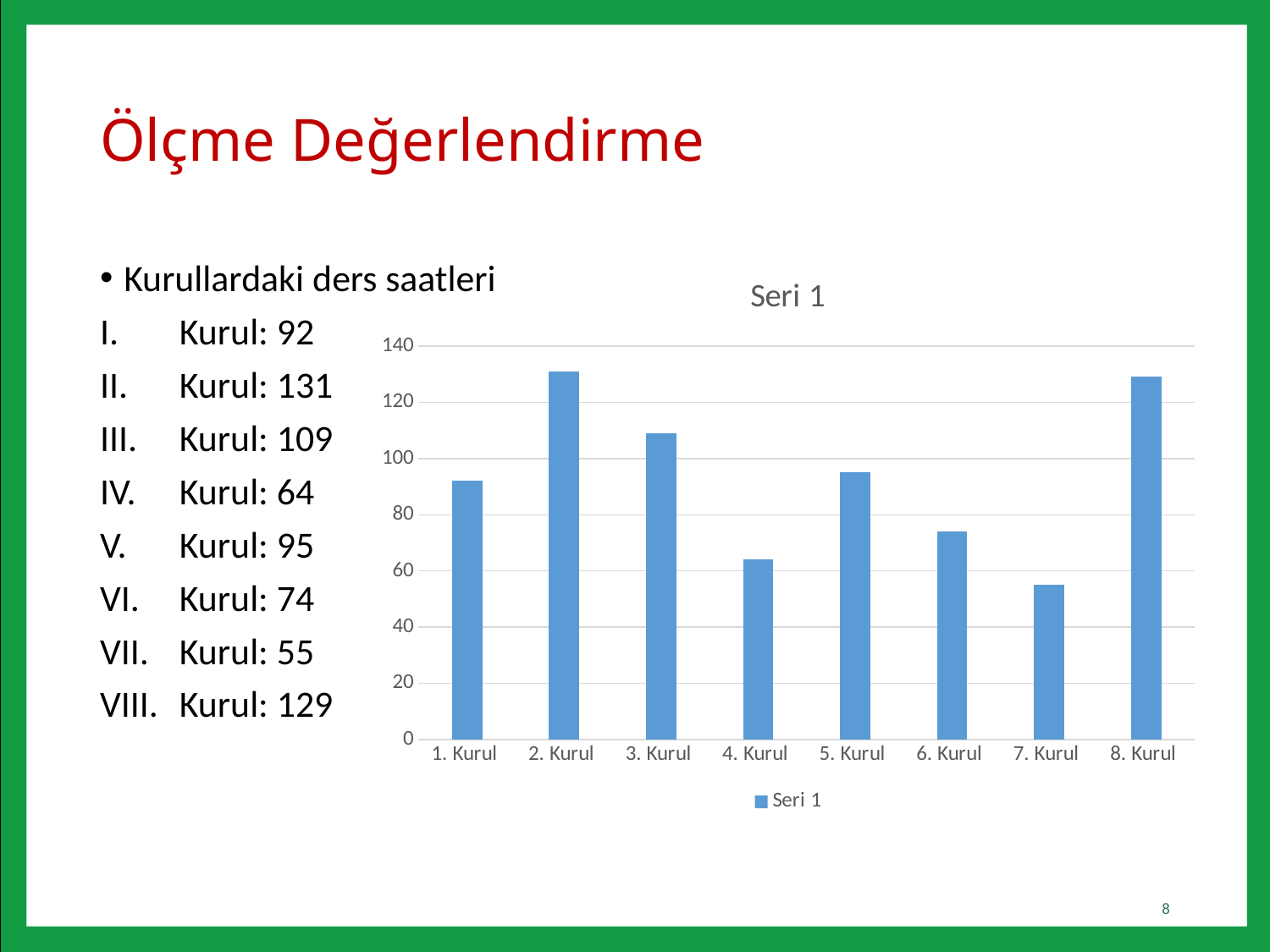
According to the slide, what is the number of ders saatleri for II. Kurul? 131 According to the values listed on the slide, what is the difference between II. Kurul (131) and VII. Kurul (55)? 76 How many categories (Kurul) are shown on the x axis of the chart? 8 Is the value for 8. Kurul greater or less than 120? greater How many series does the chart legend list? 1 Which is larger, the bar for 3. Kurul or the bar for 6. Kurul? 3. Kurul Which Kurul has the lowest bar in the chart? 7. Kurul Which Kurul has the highest bar in the chart? 2. Kurul What is the title of the chart? Seri 1 What type of chart is shown on the slide? bar chart Is the value for 4. Kurul greater or less than 80? less Is the value for 5. Kurul greater or less than 100? less